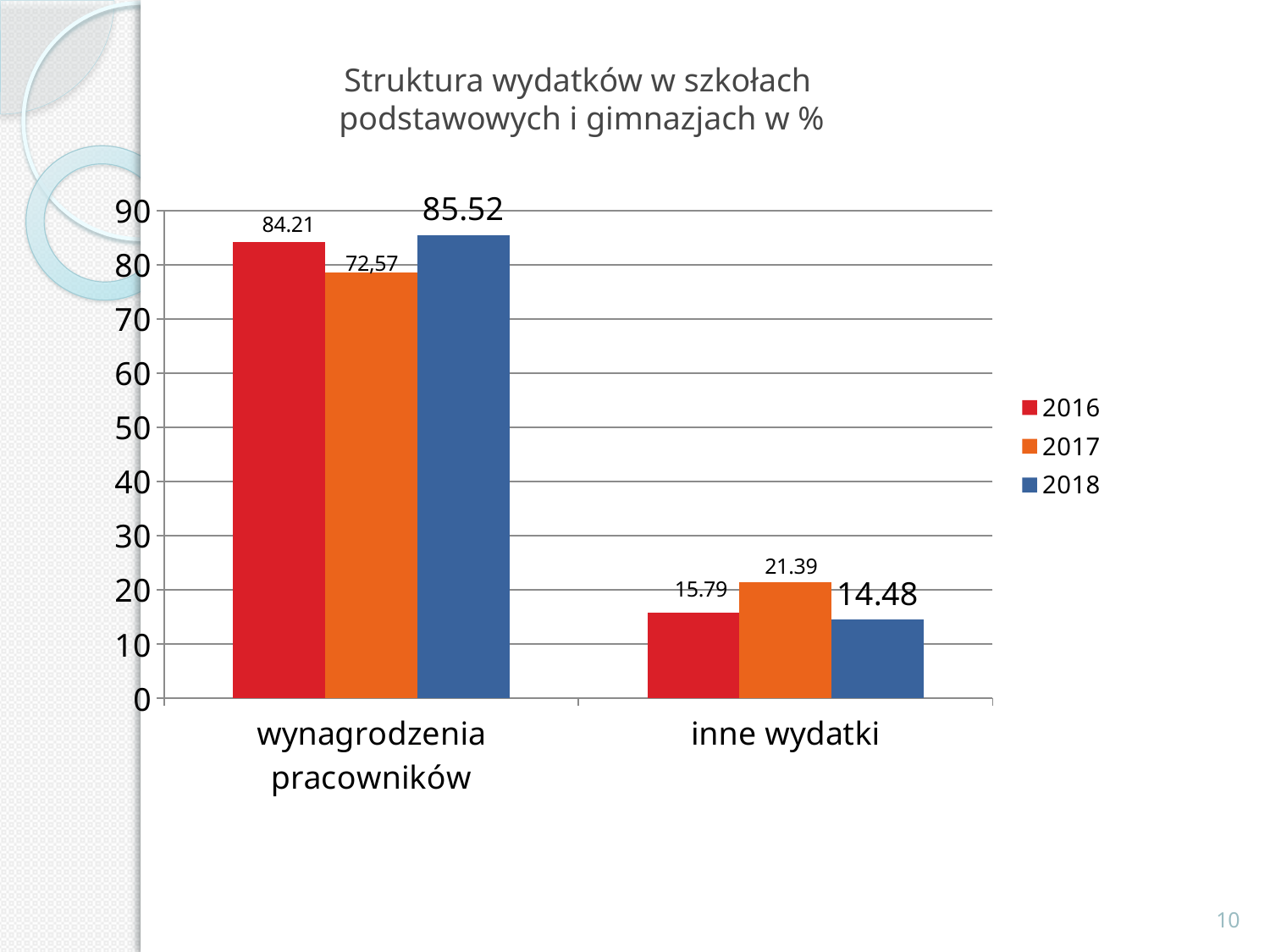
What is the difference between the 2018 and 2016 values for wynagrodzenia pracowników? 1.31 Is the value for 2017 in the wynagrodzenia pracowników category greater or less than 70? greater Which year has the lowest value in the inne wydatki category? 2018 What is the value for 2017 in the inne wydatki category? 21.39 What kind of chart is shown on the slide? bar chart Which year has the highest value in the inne wydatki category? 2017 What is the value for 2018 in the inne wydatki category? 14.48 What is the value for 2016 in the wynagrodzenia pracowników category? 84.21 How many categories are shown on the x axis? 2 How many series does the legend list? 3 What is the value for 2018 in the wynagrodzenia pracowników category? 85.52 What is the difference between the 2017 and 2018 values for inne wydatki? 6.91